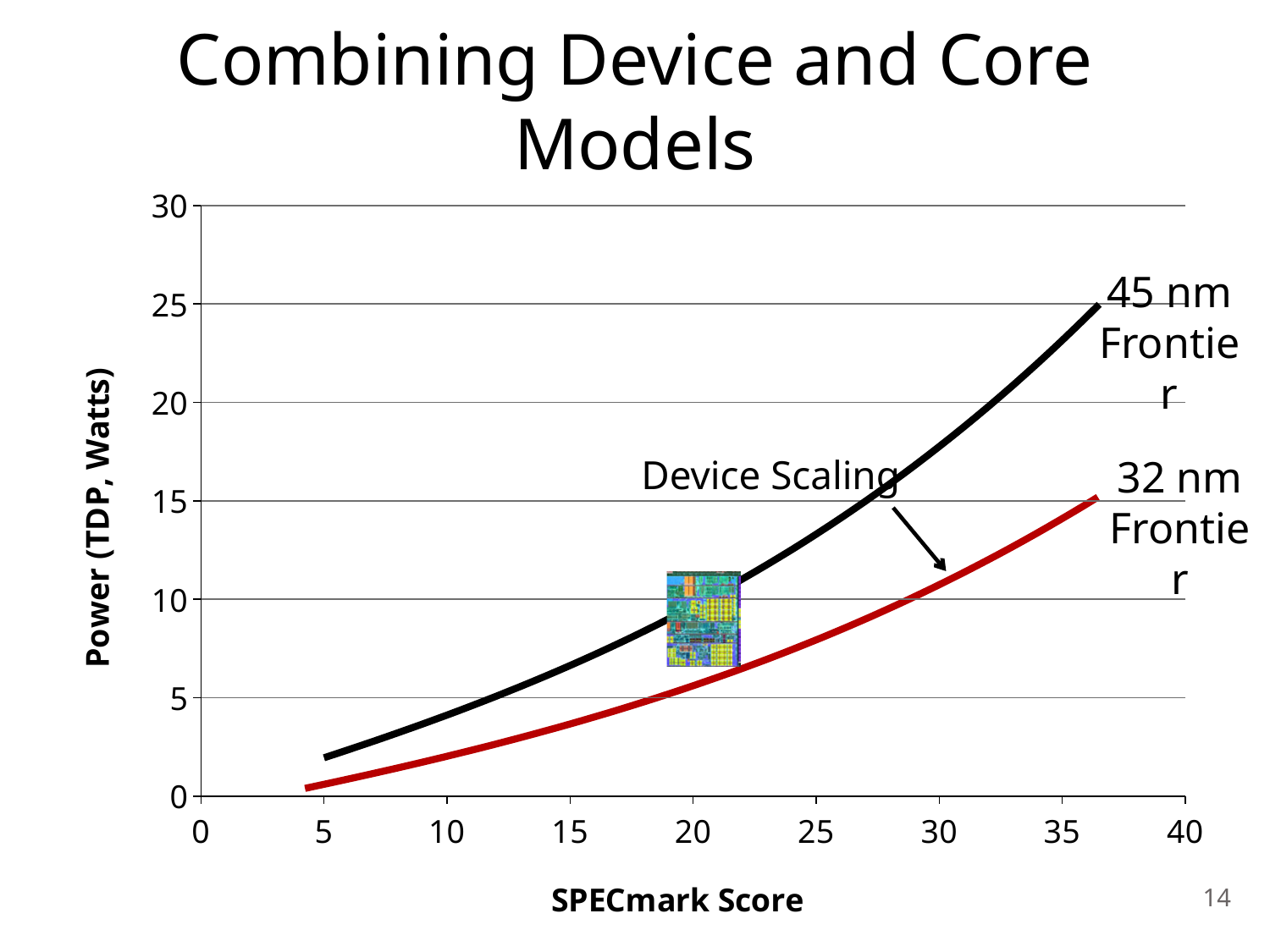
What is the label of the y axis? Power (TDP, Watts) Is the power of the 45 nm Frontier at a SPECmark Score of 35 greater or less than 20 Watts? greater Is the power of the 32 nm Frontier at a SPECmark Score of 35 greater or less than 15 Watts? less Is the power of the 45 nm Frontier at a SPECmark Score of 10 greater or less than 5 Watts? less What is the label of the x axis? SPECmark Score Which frontier curve lies lower on the chart across the whole SPECmark range? 32 nm Frontier What kind of chart is shown on the slide? line chart Does the power of the 32 nm Frontier rise or fall as the SPECmark Score increases? rise At a SPECmark Score of 30, which frontier has the higher power, 45 nm or 32 nm? 45 nm Frontier Does the power of the 45 nm Frontier rise or fall as the SPECmark Score increases? rise How many curves (frontiers) are plotted on the chart? 2